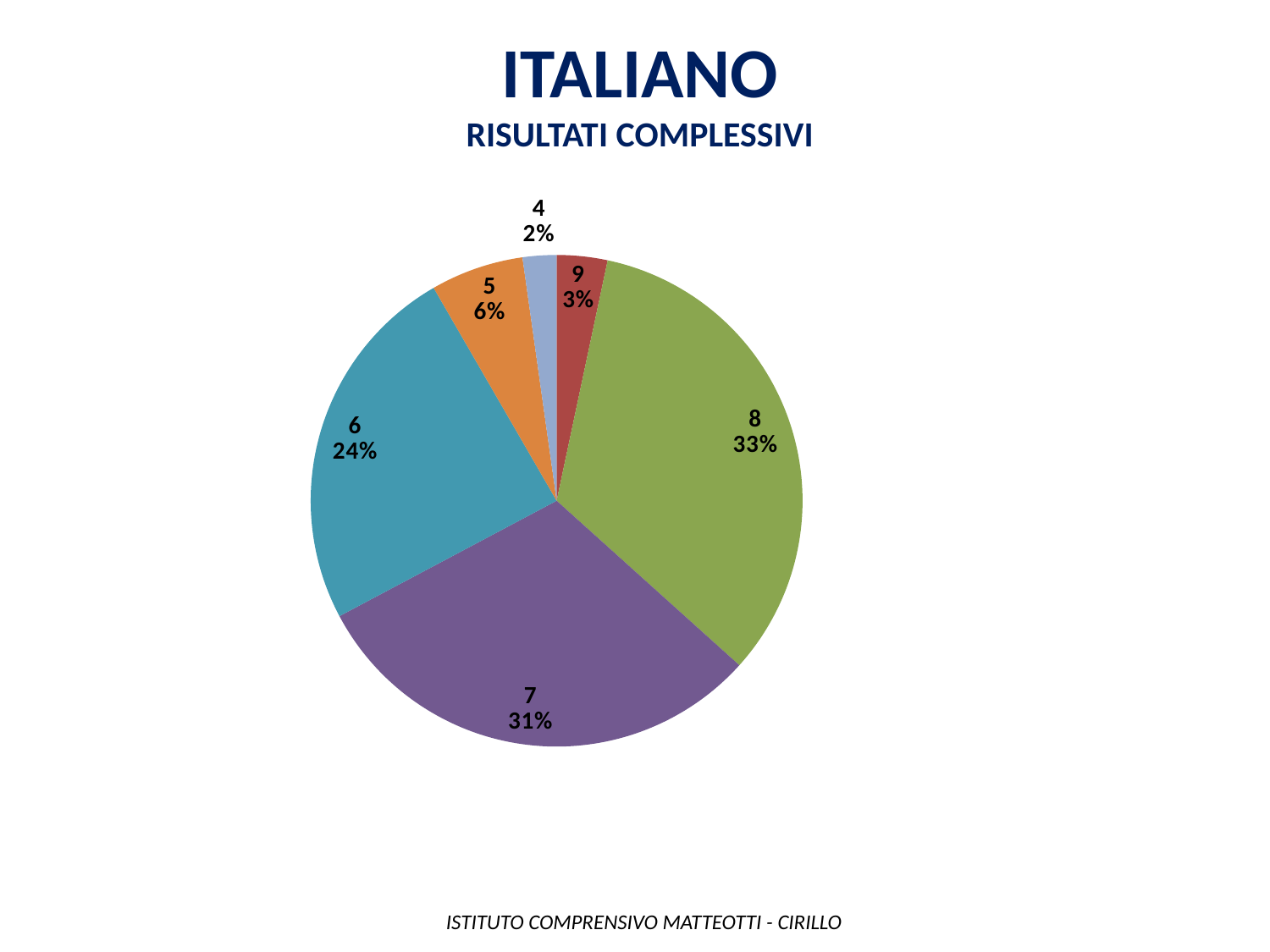
What kind of chart is shown on the slide? pie chart What share of the pie does the slice labelled 7 represent? 31% Which slice has the largest share of the pie? 8 What is the difference in percentage points between the slices labelled 8 and 7? 2 What share of the pie does the slice labelled 6 represent? 24% Which slice is larger, the one labelled 6 or the one labelled 5? 6 What share of the pie does the slice labelled 4 represent? 2% How many slices does the pie chart have? 6 Which slice has the smallest share of the pie? 4